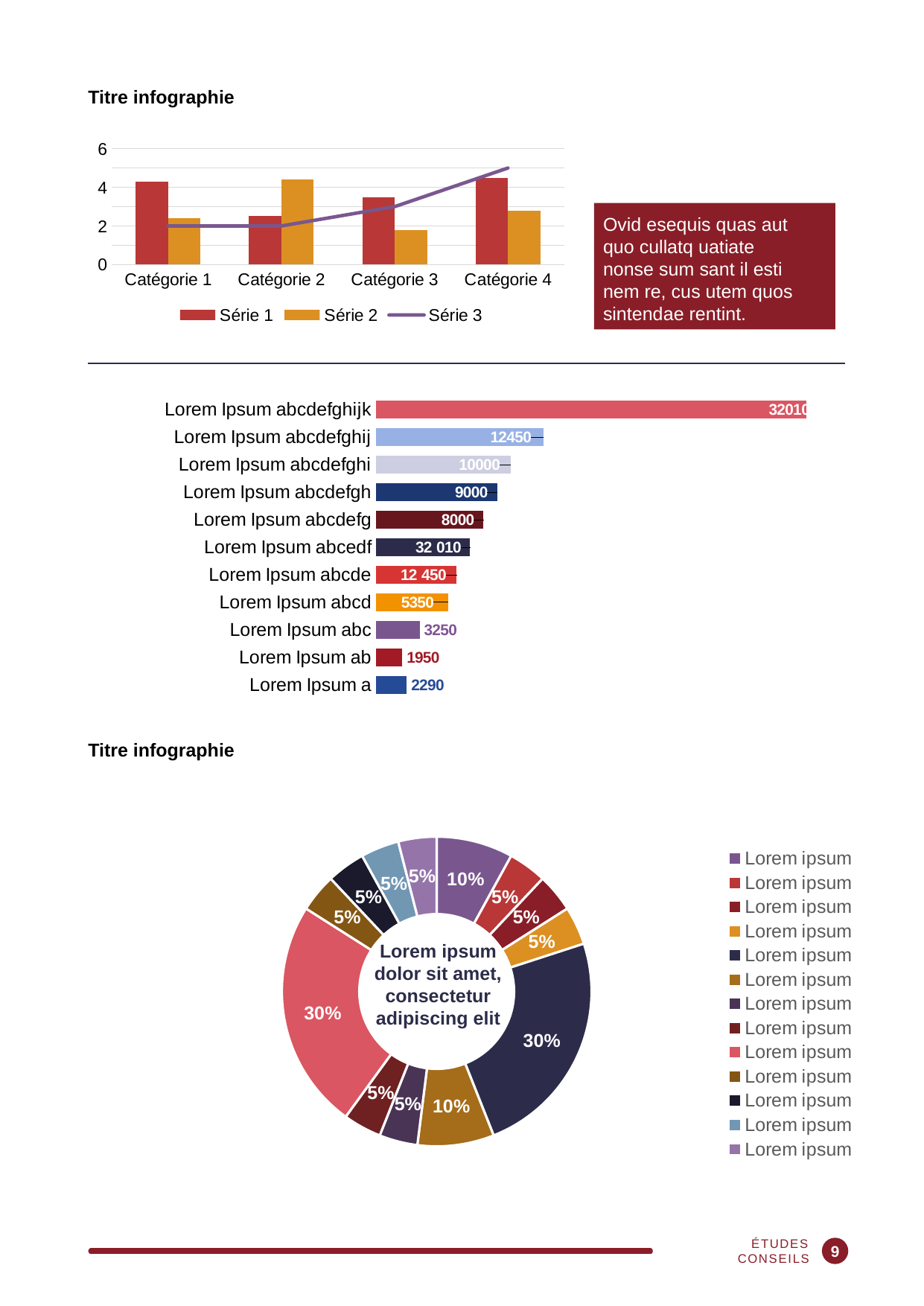
In the top chart, how many series does the legend list? 3 In the middle horizontal bar chart, how many categories are plotted? 11 In the middle horizontal bar chart, what is the difference between the values for Lorem Ipsum abcdefgh and Lorem Ipsum abcdefg? 1000 In the top chart, does the Série 3 line rise or fall from Catégorie 2 to Catégorie 4? rise In the middle horizontal bar chart, which is larger: the value for Lorem Ipsum ab or Lorem Ipsum a? Lorem Ipsum a In the top chart, is the value of Série 1 for Catégorie 1 greater or less than 4? greater What kind of chart is the bottom chart? doughnut (pie) chart In the bottom doughnut chart, how many entries does the legend list? 13 In the middle horizontal bar chart, what is the value for Lorem Ipsum abcdefghij? 12450 In the middle horizontal bar chart, what is the value for Lorem Ipsum abcd? 5350 In the top chart, how many categories are shown on the x axis? 4